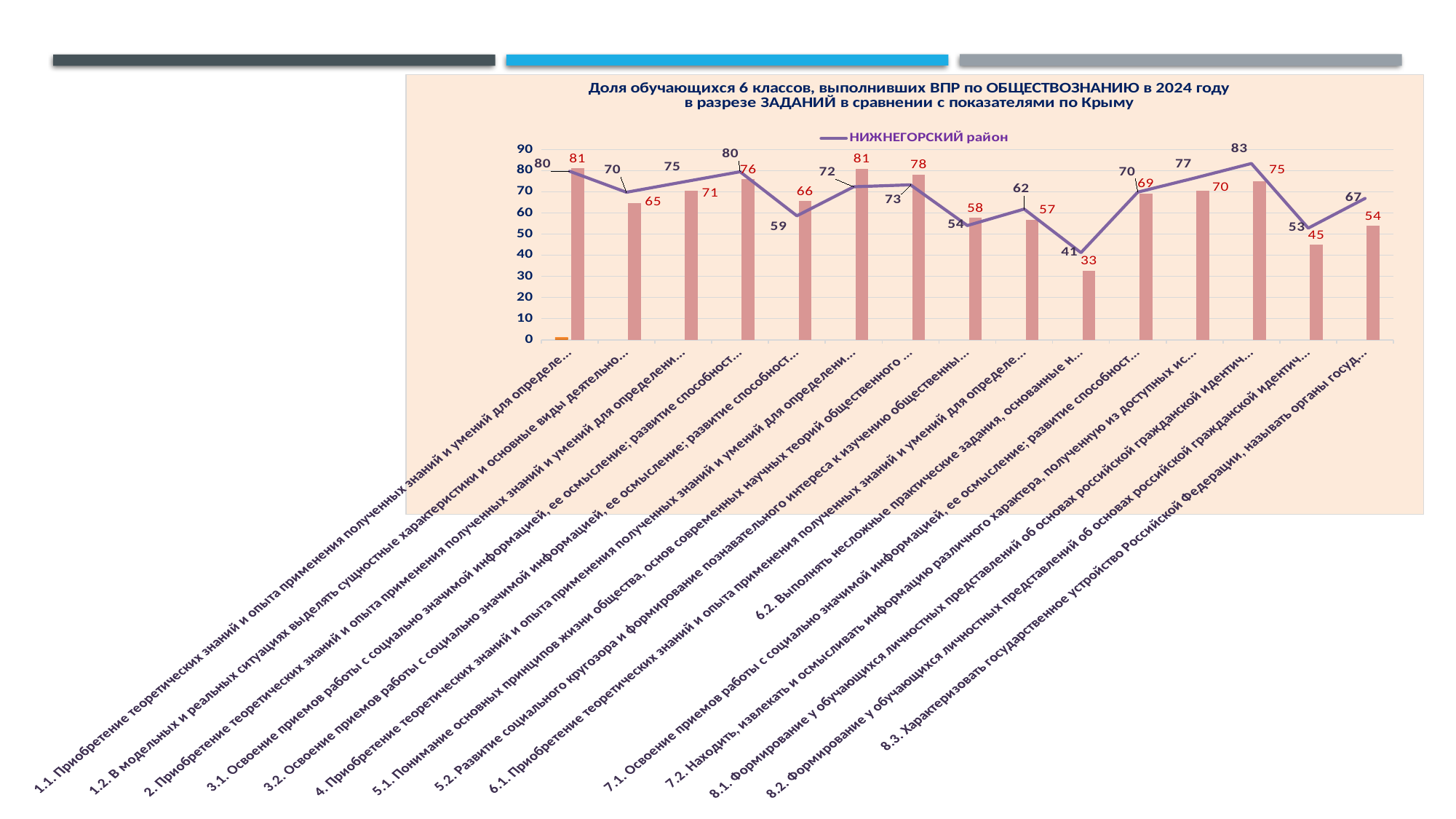
How many tasks (categories) are shown on the x axis? 15 For which task does the НИЖНЕГОРСКИЙ район line reach its highest value? 8.1 What is the value of the НИЖНЕГОРСКИЙ район line for task 8.3? 67 For task 3.2, which is larger: the bar value or the НИЖНЕГОРСКИЙ район line value? the bar value For which task does the НИЖНЕГОРСКИЙ район line have its lowest value? 6.2 By how much does the НИЖНЕГОРСКИЙ район line value for task 8.1 exceed its value for task 8.2? 30 Which task has the lowest bar value? 6.2 What is the value of the НИЖНЕГОРСКИЙ район line for task 6.2? 41 What is the value of the bar for task 6.2? 33 What is the difference between the НИЖНЕГОРСКИЙ район line value and the bar value for task 7.2? 7 What kind of chart is this? a combined bar and line chart How many series does the legend list? 1